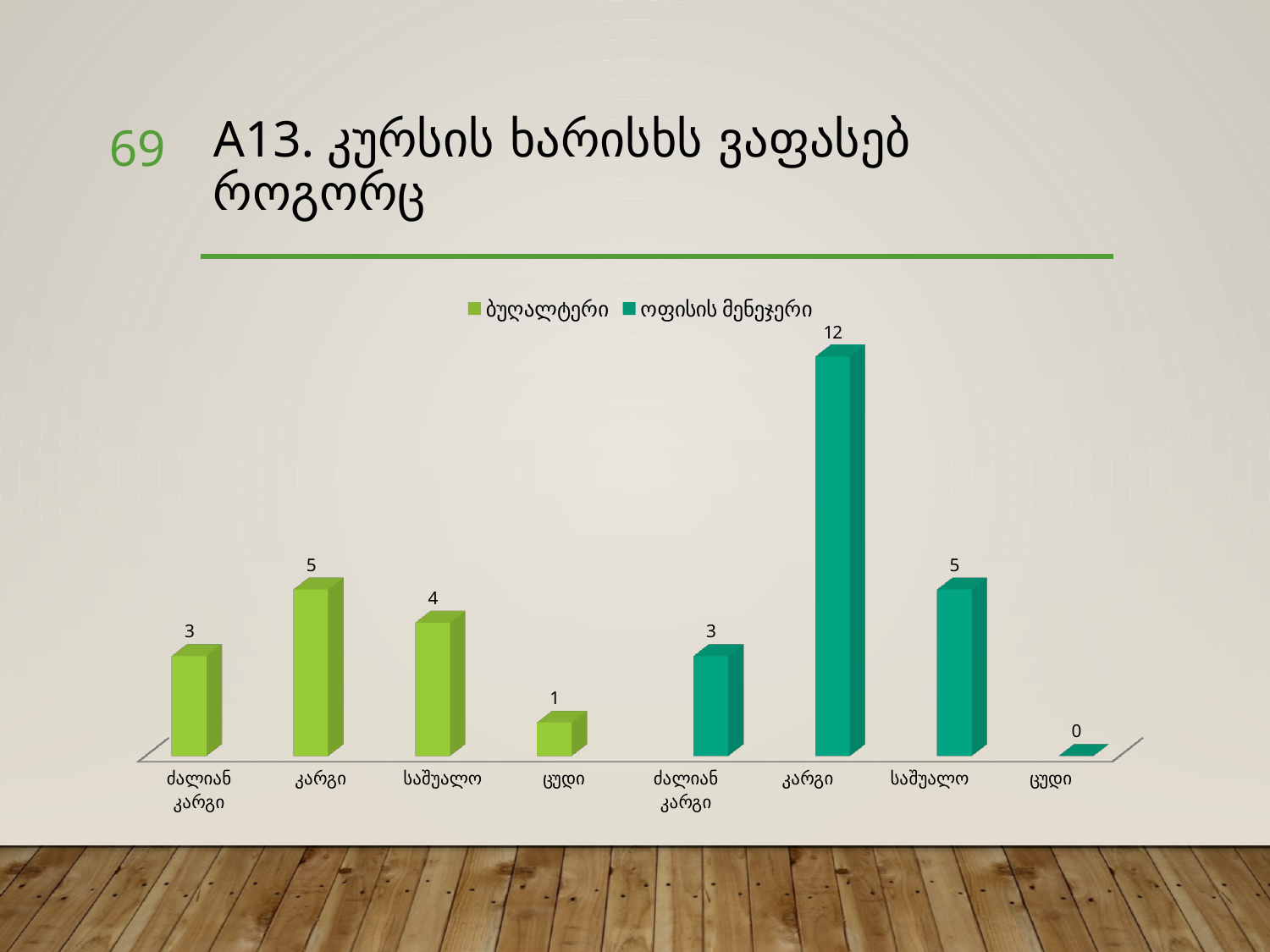
How many series does the legend list? 2 What value is shown for ბუღალტერი in the კარგი category? 5 Which category has the lowest value for ბუღალტერი? ცუდი What is the total of the ბუღალტერი values across all four categories? 13 Which category has the highest value for ოფისის მენეჯერი? კარგი How many categories are shown for each series? 4 What is the difference between the ოფისის მენეჯერი and ბუღალტერი values in the კარგი category? 7 What value is shown for ოფისის მენეჯერი in the ცუდი category? 0 Which is larger: the ბუღალტერი value for საშუალო or the ოფისის მენეჯერი value for საშუალო? ოფისის მენეჯერი What kind of chart is shown on the slide? Bar chart What value is shown for ოფისის მენეჯერი in the კარგი category? 12 What value is shown for ბუღალტერი in the საშუალო category? 4